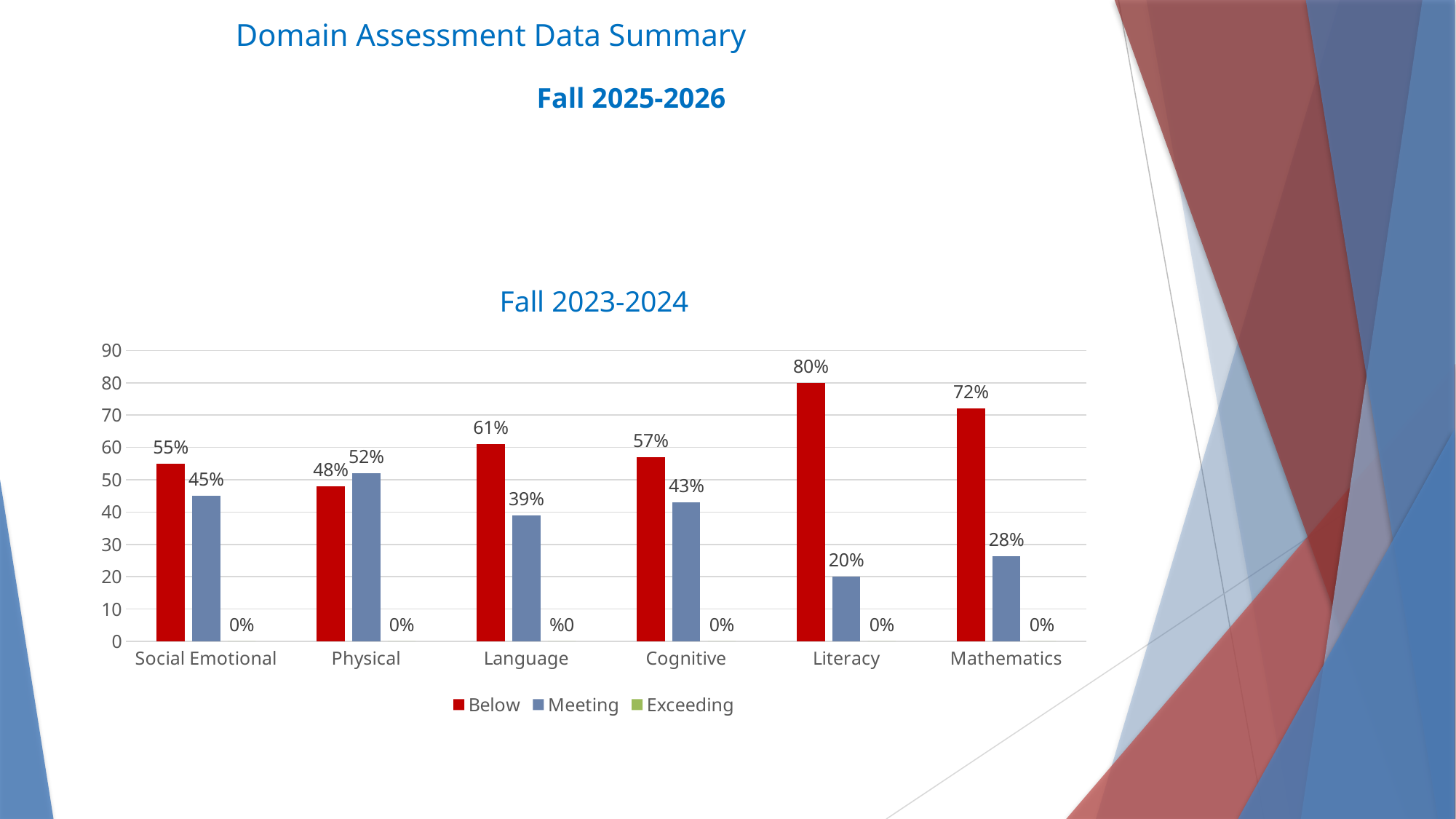
Is the Below value for Mathematics greater or less than 70? greater What is the title of the chart? Fall 2023-2024 What is the difference between the Below and Meeting values for Cognitive? 14% What is the Below value for Literacy? 80% Which is larger for Physical, the Below value or the Meeting value? Meeting What is the Meeting value for Physical? 52% Which category has the highest Below value? Literacy How many categories are shown on the x axis? 6 What kind of chart is shown? bar chart Which category has the lowest Meeting value? Literacy How many series does the legend list? 3 What is the Meeting value for Mathematics? 28%